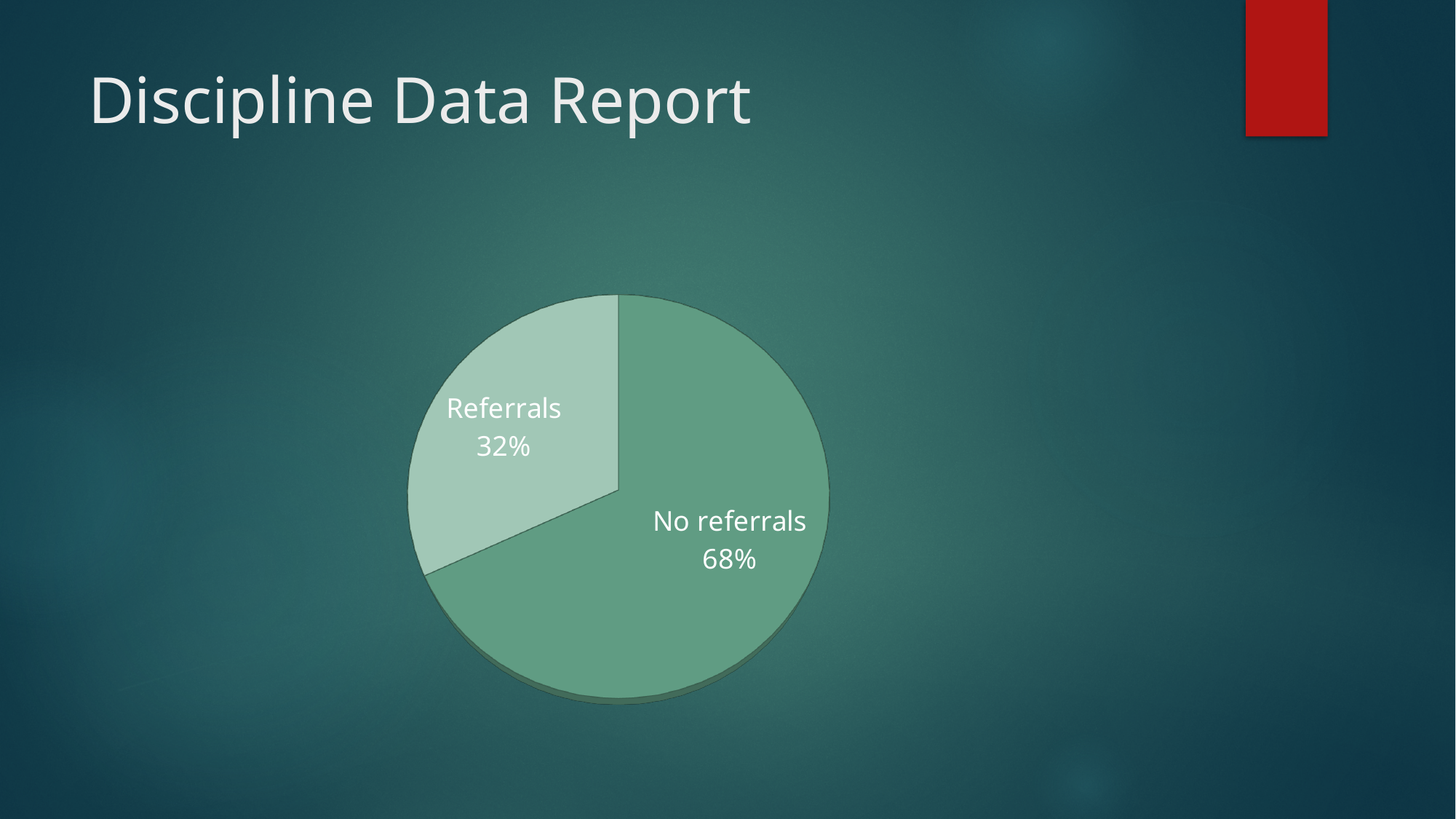
Which slice of the pie is the smallest? Referrals Which slice of the pie is shown in the lighter colour? Referrals What is the title of the slide containing the pie chart? Discipline Data Report Is the share for No referrals greater or less than 50%? greater What kind of chart is shown on the slide? pie chart What is the difference in percentage points between the No referrals slice and the Referrals slice? 36 Is the share for Referrals greater or less than 50%? less Which is larger, the Referrals slice or the No referrals slice? No referrals How many slices does the pie chart have? 2 Which slice of the pie is the largest? No referrals What share of the pie does the Referrals slice represent? 32% What share of the pie does the No referrals slice represent? 68%